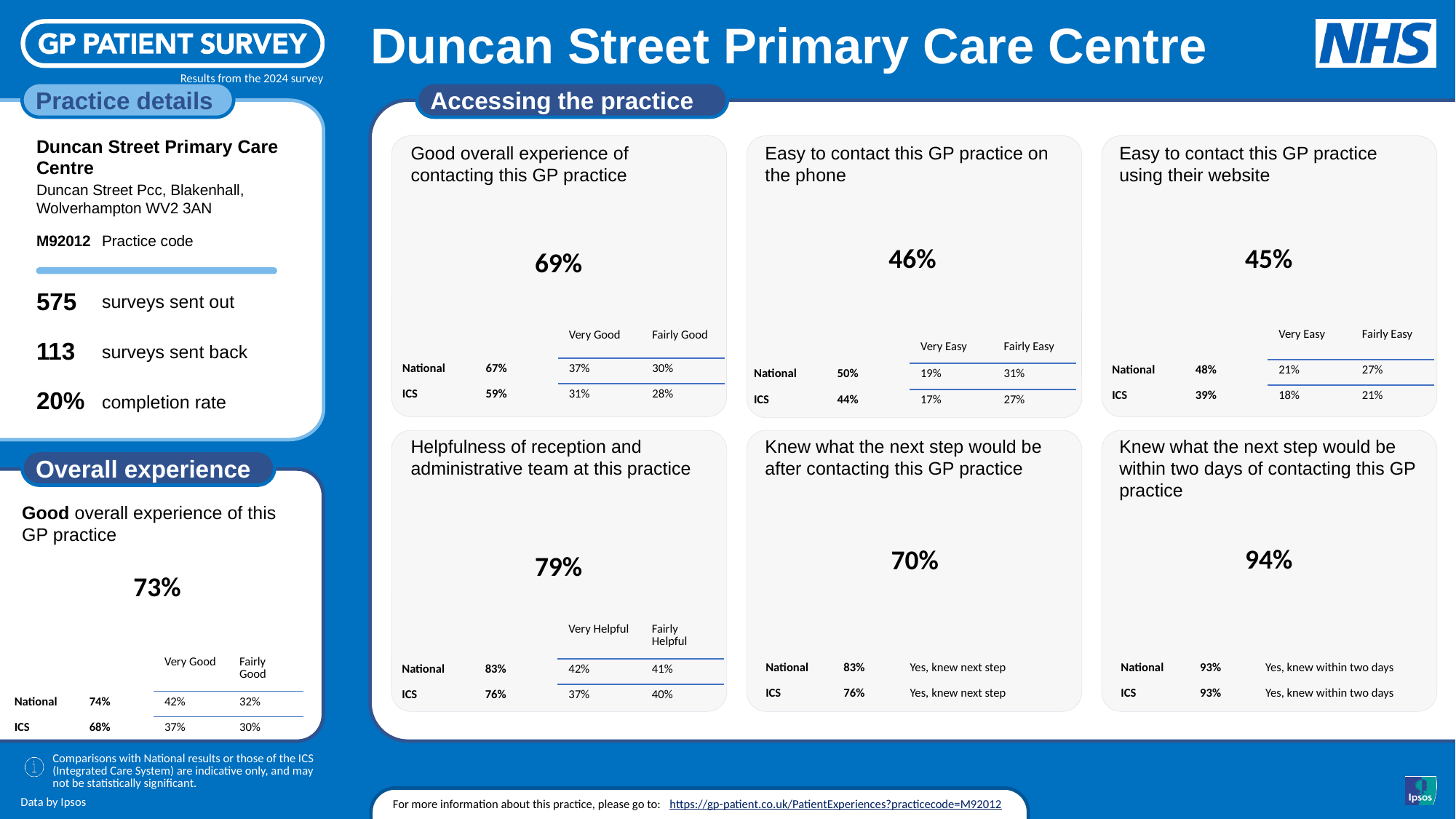
In the 'Overall experience' panel, what is the ICS 'Fairly Good' percentage? 30% In the 'Easy to contact this GP practice on the phone' panel, which is larger, the practice's headline value or the ICS value? the practice's headline value In the 'Good overall experience of contacting this GP practice' panel, what is the difference between the National value and the ICS value? 8% In the 'Helpfulness of reception and administrative team at this practice' panel, what is the National 'Very Helpful' percentage? 42% In the 'Knew what the next step would be within two days of contacting this GP practice' panel, what is the practice's headline percentage? 94% In the 'Easy to contact this GP practice using their website' panel, what is the ICS value? 39% How many panels are shown in the 'Accessing the practice' section? 6 In the 'Knew what the next step would be after contacting this GP practice' panel, which is larger, the practice's headline value or the National value? National In the 'Good overall experience of contacting this GP practice' panel, what is the practice's headline percentage? 69% In the 'Easy to contact this GP practice on the phone' panel, what is the National value? 50% Across the six 'Accessing the practice' panels, which has the lowest practice headline percentage? Easy to contact this GP practice using their website Across the six 'Accessing the practice' panels, which has the highest practice headline percentage? Knew what the next step would be within two days of contacting this GP practice